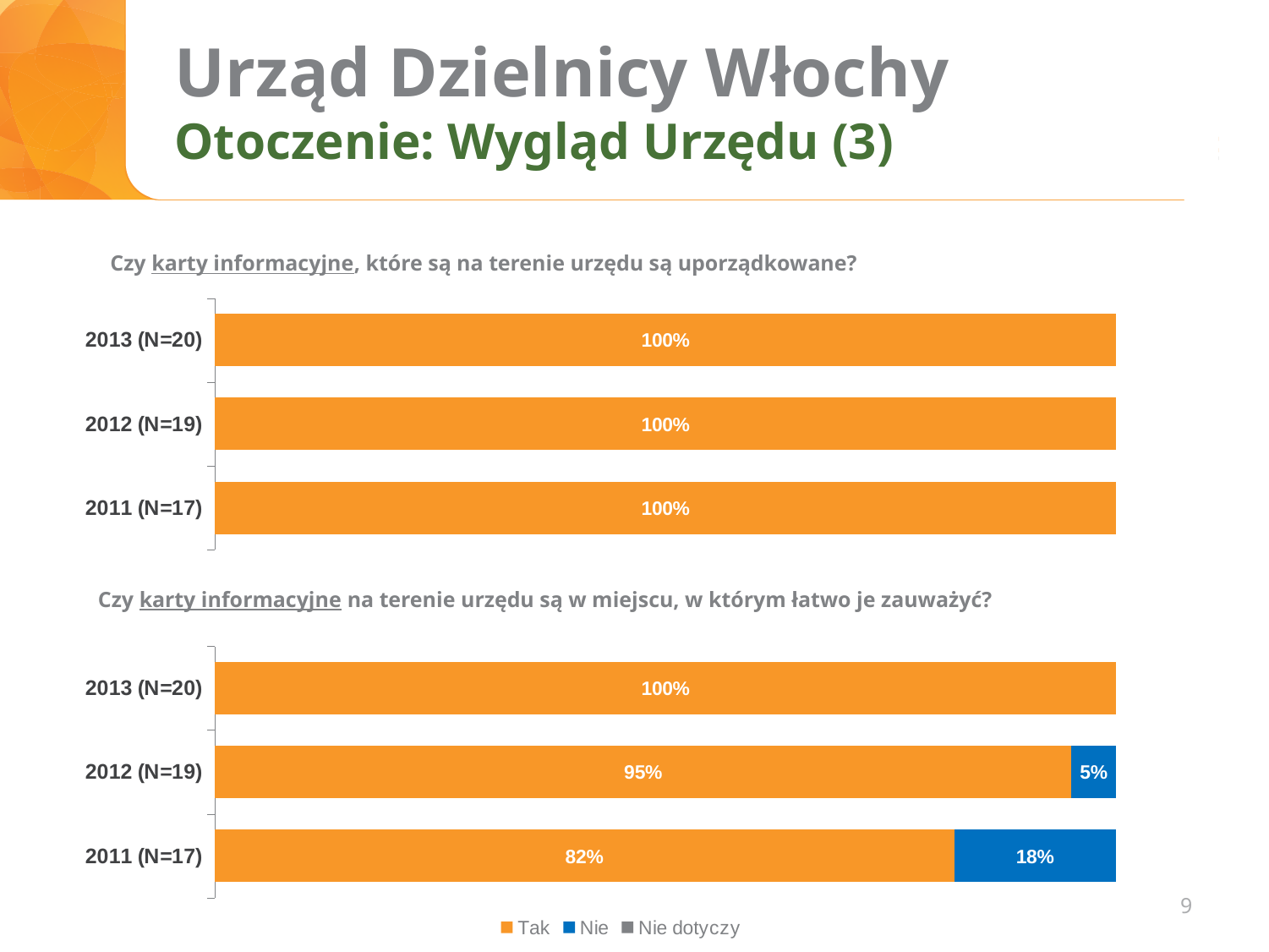
In the bottom chart, which year has the highest 'Nie' value? 2011 (N=17) In the bottom chart, is the 'Tak' value larger for 2012 (N=19) or 2011 (N=17)? 2012 (N=19) In the bottom chart, what is the difference between the 'Tak' values for 2013 (N=20) and 2011 (N=17)? 18% How many series does the legend at the bottom of the slide list? 3 In the bottom chart, what is the 'Tak' value for 2011 (N=17)? 82% In the top chart, what is the 'Tak' value for 2012 (N=19)? 100% How many year categories does the top chart show? 3 In the bottom chart, what is the 'Nie' value for 2011 (N=17)? 18% In the bottom chart, does the 'Tak' value rise or fall from 2011 to 2013? rise In the bottom chart, what is the 'Nie' value for 2012 (N=19)? 5% What type of chart is the bottom chart? stacked bar chart In the bottom chart, which year has the lowest 'Tak' value? 2011 (N=17)